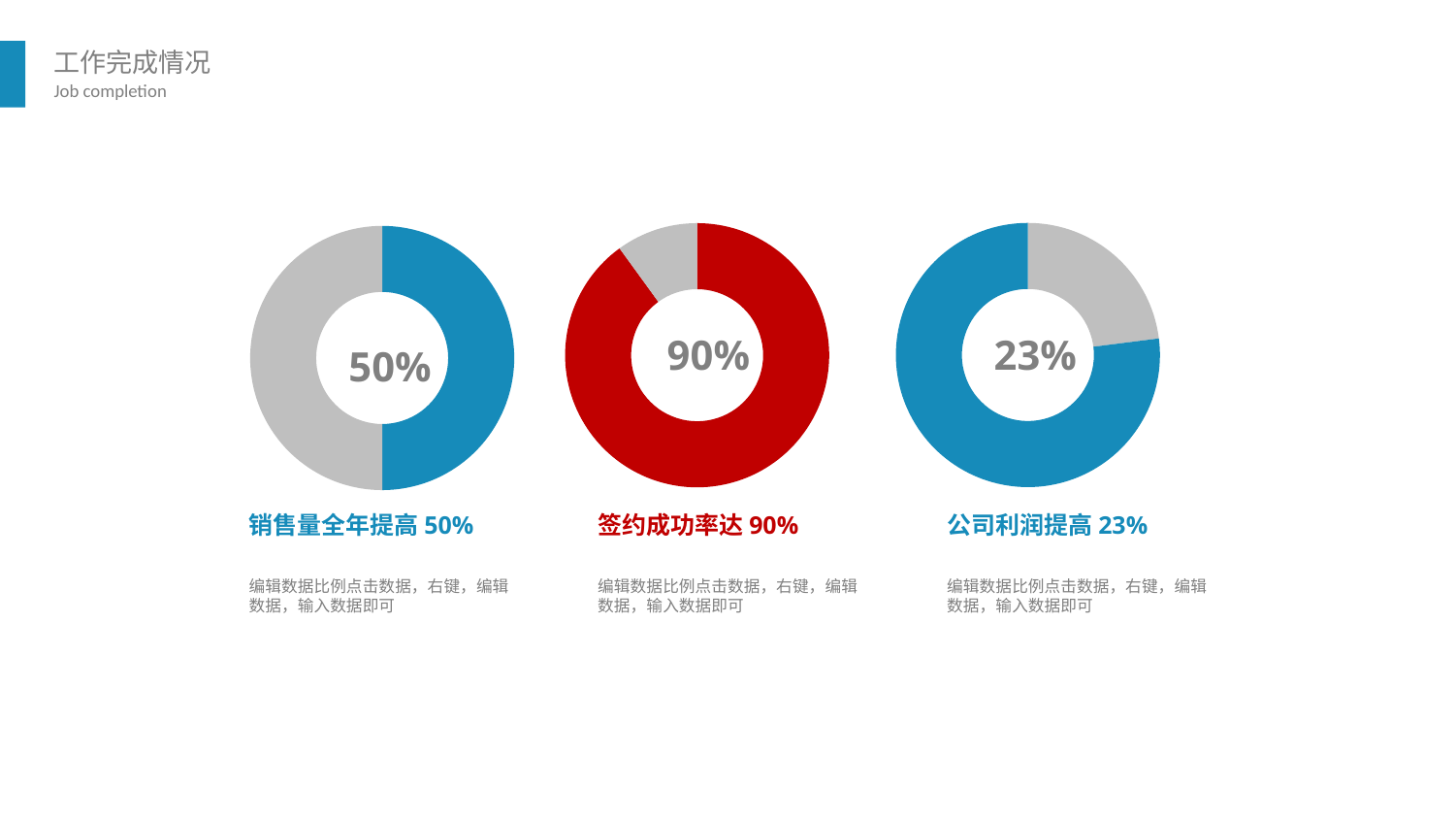
How many donut charts are on the slide? 3 What is the difference between the percentage in the middle chart (90%) and the left chart (50%)? 40 percentage points In the right donut chart (公司利润提高), what percentage is shown in the centre? 23% In the middle donut chart (签约成功率达), what percentage is shown in the centre? 90% Which is larger: the percentage in the left chart (销售量) or the right chart (公司利润)? Left chart (销售量, 50%) What is the difference between the percentage in the left chart (50%) and the right chart (23%)? 27 percentage points Which of the three donut charts shows the highest percentage? 签约成功率达 90% (middle chart) Which of the three donut charts shows the lowest percentage? 公司利润提高 23% (right chart) What is the caption under the right donut chart? 公司利润提高 23% In the left donut chart (销售量全年提高), what percentage is shown in the centre? 50% What type of chart is used on this slide? Donut (pie) chart What colour is the filled portion of the middle donut chart? Red